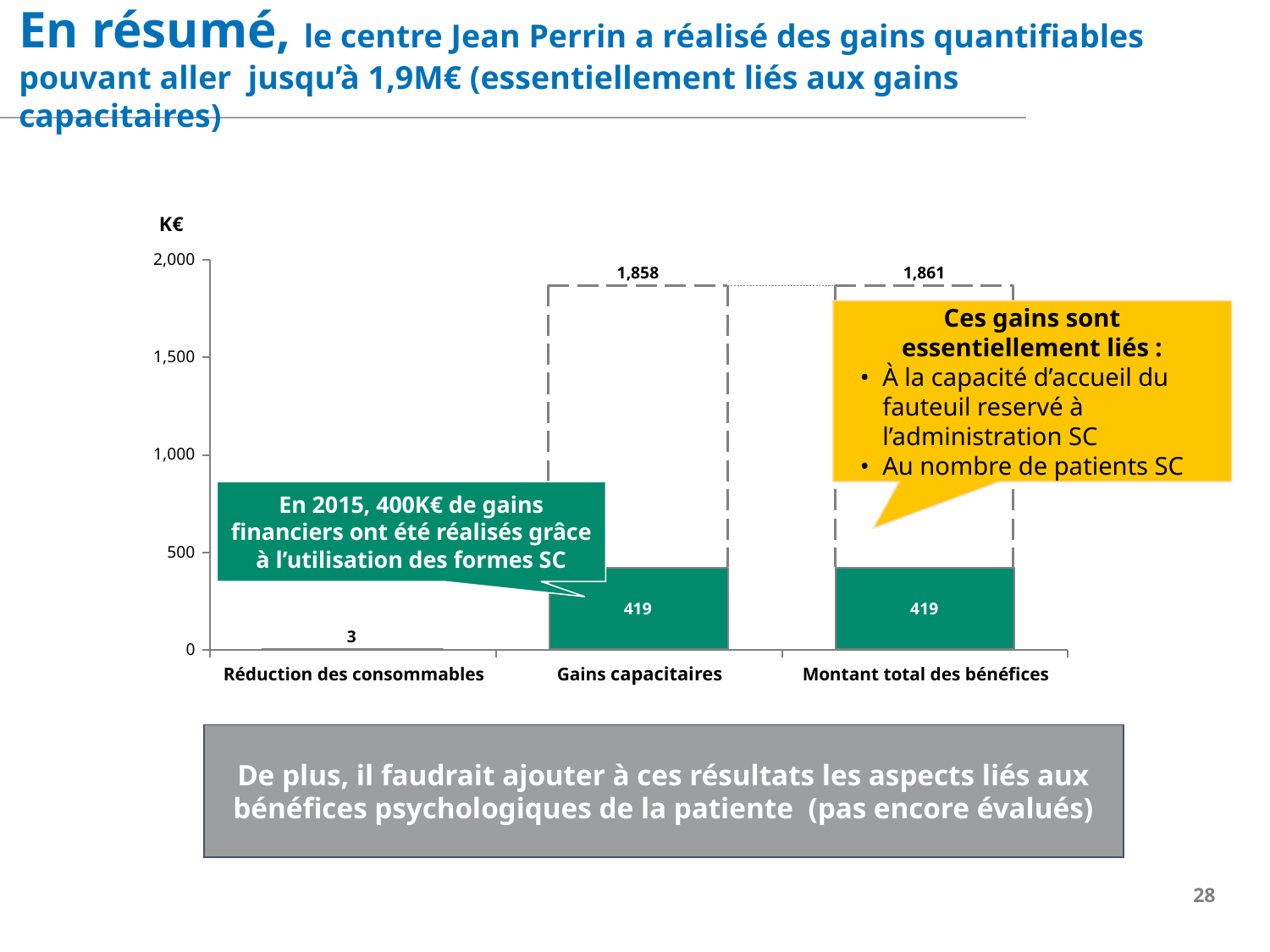
What is the value of the solid green bar for Gains capacitaires? 419 What unit is indicated at the top of the y axis? K€ What kind of chart is shown on the slide? bar chart What value is labelled at the top of the dashed bar for Gains capacitaires? 1,858 What is the difference between the solid bar value for Gains capacitaires and the value for Réduction des consommables? 416 Which category has the lowest value? Réduction des consommables Which category has the highest labelled value? Montant total des bénéfices What is the difference between the dashed-bar values for Montant total des bénéfices and Gains capacitaires? 3 What value is labelled at the top of the dashed bar for Montant total des bénéfices? 1,861 What value is shown for Réduction des consommables? 3 How many categories are shown on the x axis? 3 Is the solid green bar for Gains capacitaires greater or less than 500? less